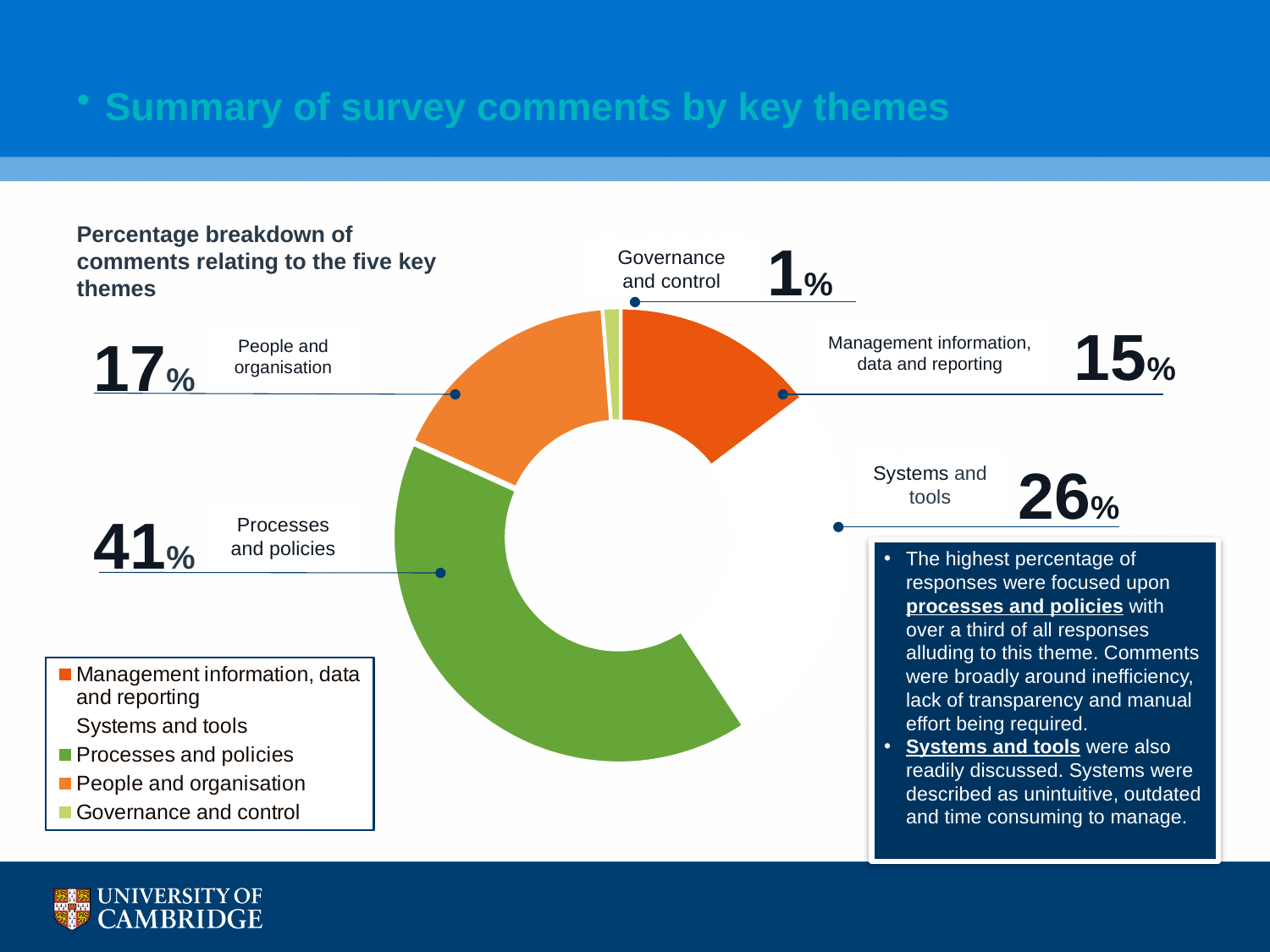
Which theme has the highest percentage of comments? Processes and policies Which has a larger share of comments, People and organisation or Management information, data and reporting? People and organisation What percentage of comments relate to Governance and control? 1% What percentage of comments relate to Processes and policies? 41% What is the combined percentage of comments for Processes and policies and People and organisation? 58% How many key themes are shown in the chart? 5 Which theme has the lowest percentage of comments? Governance and control What kind of chart is used to show the percentage breakdown of comments? Doughnut (pie) chart What percentage of comments relate to Systems and tools? 26% What is the difference in percentage points between Processes and policies and Systems and tools? 15 What colour represents Processes and policies in the chart? Green What percentage of comments relate to Management information, data and reporting? 15%